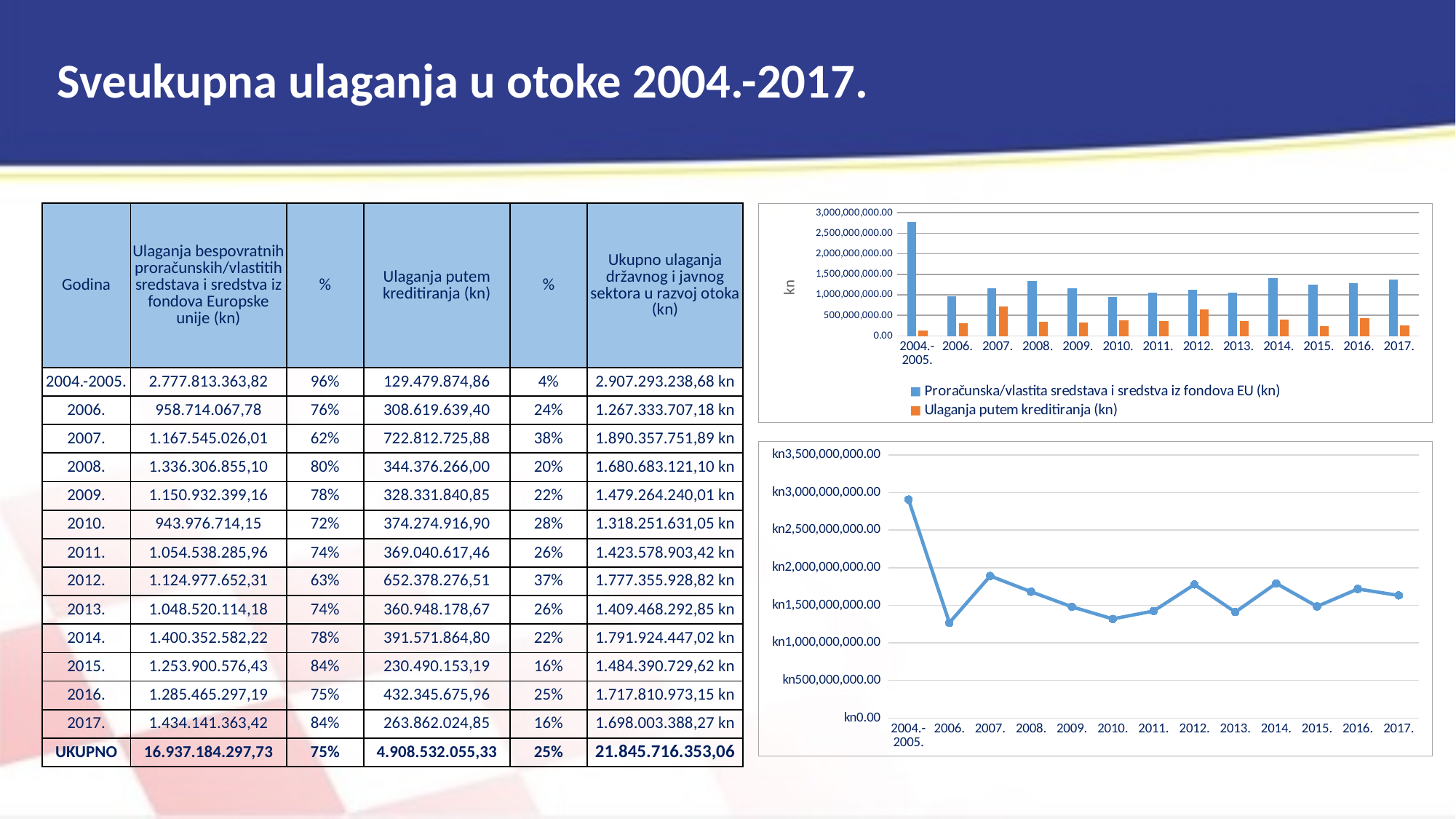
What kind of chart is the top-right chart on the slide? bar chart In the top-right bar chart, which category has the highest value for Ulaganja putem kreditiranja (kn)? 2007. What kind of chart is the bottom-right chart on the slide? line chart In the top-right bar chart, how many series does the legend list? 2 In the top-right bar chart, is the value for Ulaganja putem kreditiranja (kn) in 2007. greater or less than 500,000,000.00? greater In the top-right bar chart, which is larger for Ulaganja putem kreditiranja (kn): 2007. or 2008.? 2007. In the top-right bar chart, is the value for Proračunska/vlastita sredstava i sredstva iz fondova EU (kn) in 2004.-2005. greater or less than 2,500,000,000.00? greater In the bottom-right line chart, how many categories are shown on the x axis? 13 In the top-right bar chart, which category has the highest value for Proračunska/vlastita sredstava i sredstva iz fondova EU (kn)? 2004.-2005. In the bottom-right line chart, is the value for 2006. greater or less than kn1,500,000,000.00? less In the bottom-right line chart, does the value rise or fall from 2004.-2005. to 2006.? fall In the bottom-right line chart, which category has the highest value? 2004.-2005.